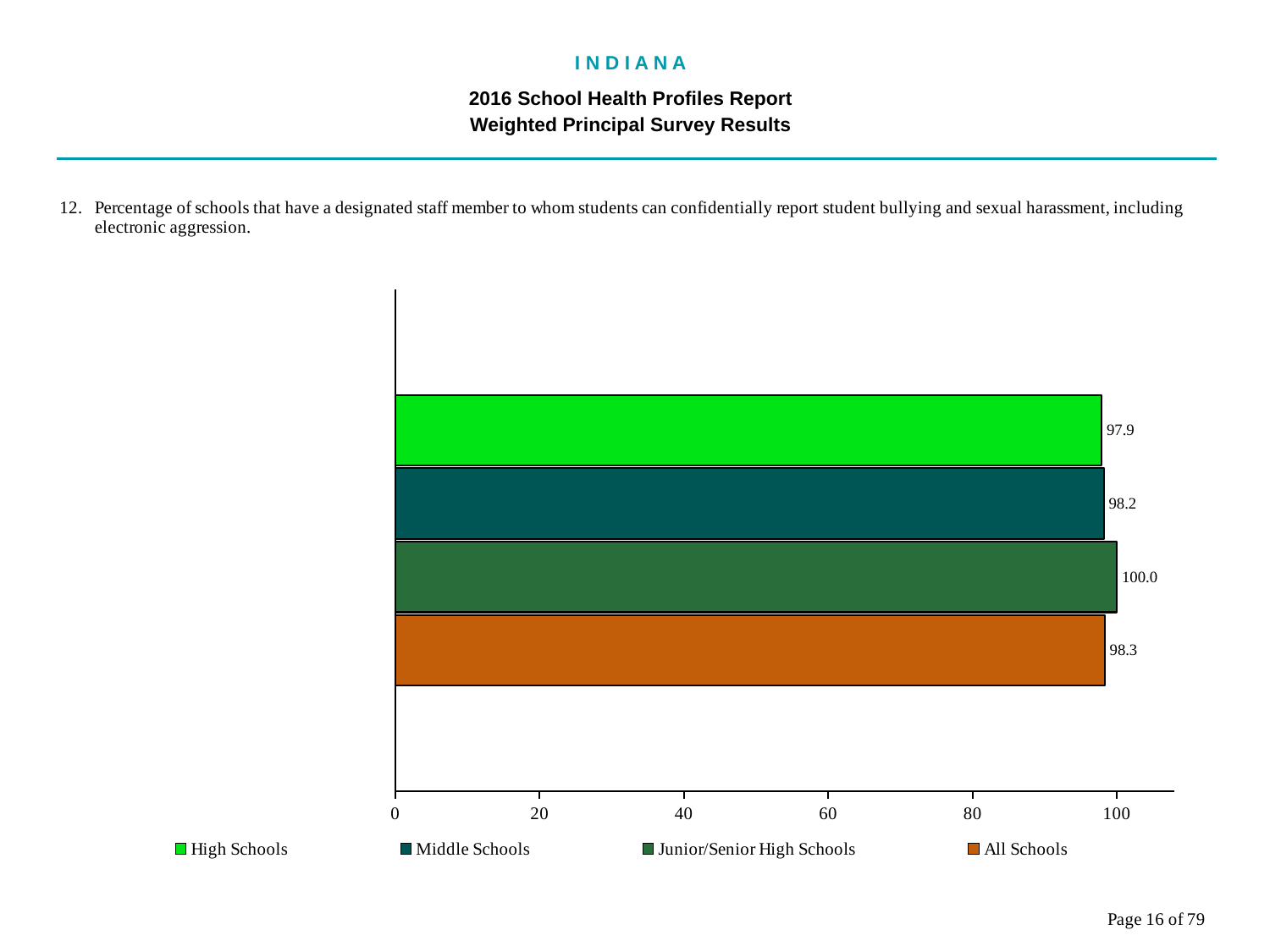
What is the difference between the values for All Schools and Middle Schools? 0.1 What kind of chart is shown on the slide? Bar chart Which school category has the lowest value? High Schools What is the value for High Schools? 97.9 How many entries does the legend list? 4 What is the difference between the values for Junior/Senior High Schools and High Schools? 2.1 What is the value for Junior/Senior High Schools? 100.0 Is the value for High Schools greater or less than 80? greater What is the value for All Schools? 98.3 How many bars are shown in the chart? 4 Which school category has the highest value? Junior/Senior High Schools What is the value for Middle Schools? 98.2